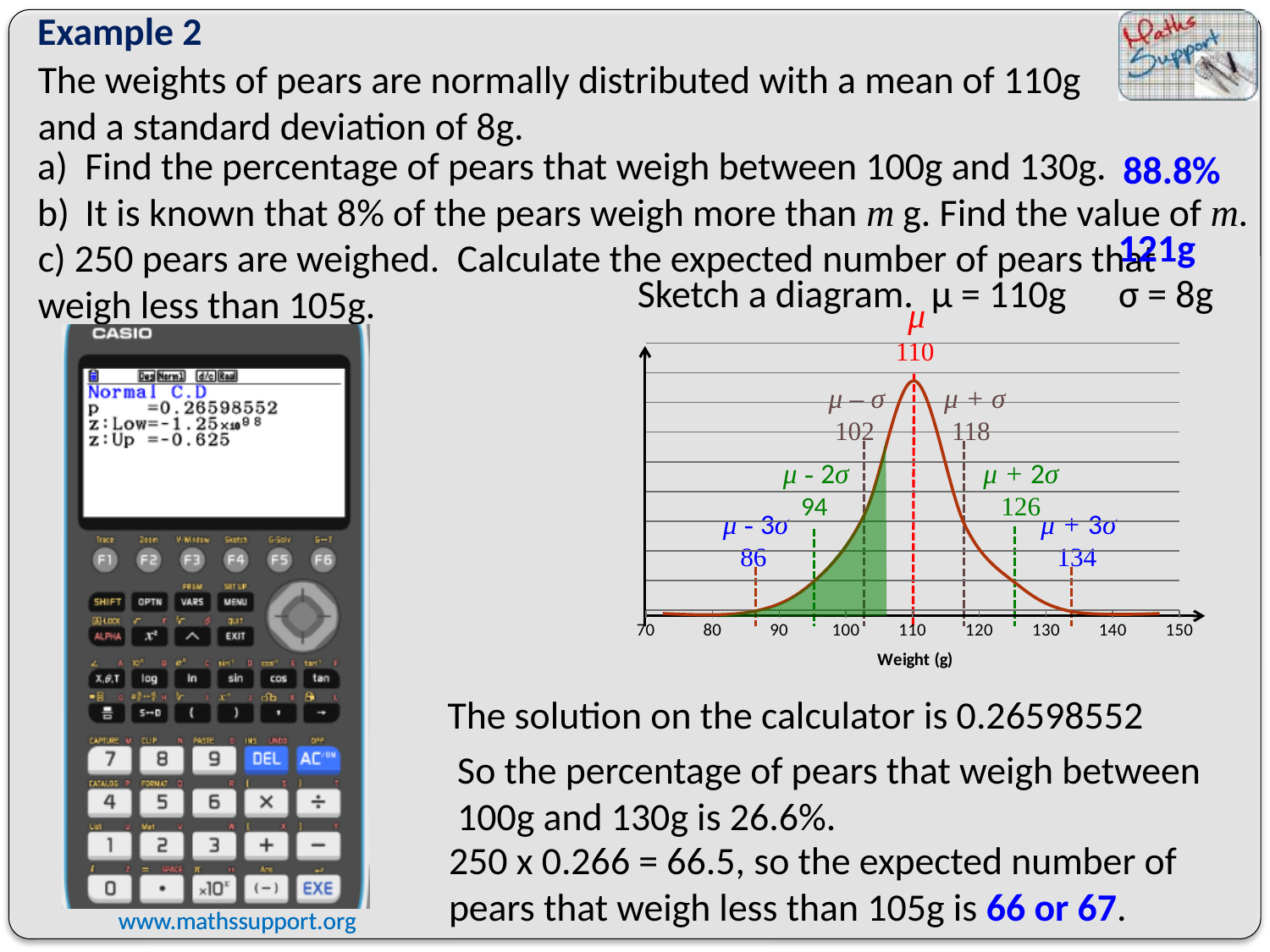
What is the label on the horizontal axis of the normal distribution diagram? Weight (g) What value is marked at μ − σ on the diagram? 102 What value is marked at μ − 3σ on the diagram? 86 Is the right-hand edge of the shaded region on the diagram at a weight greater or less than 110? less What value is marked at μ + 3σ on the diagram? 134 Does the curve on the diagram rise or fall as weight increases from 110 to 150? fall What value is marked at the mean (μ) on the diagram? 110 What value is marked at μ − 2σ on the diagram? 94 What is the difference between the values marked at μ + 3σ and μ − 3σ on the diagram? 48 What are the lowest and highest tick values shown on the horizontal axis of the diagram? 70 and 150 Which is larger on the diagram, the value marked at μ + 2σ or the value marked at μ − 2σ? μ + 2σ What value is marked at μ + σ on the diagram? 118